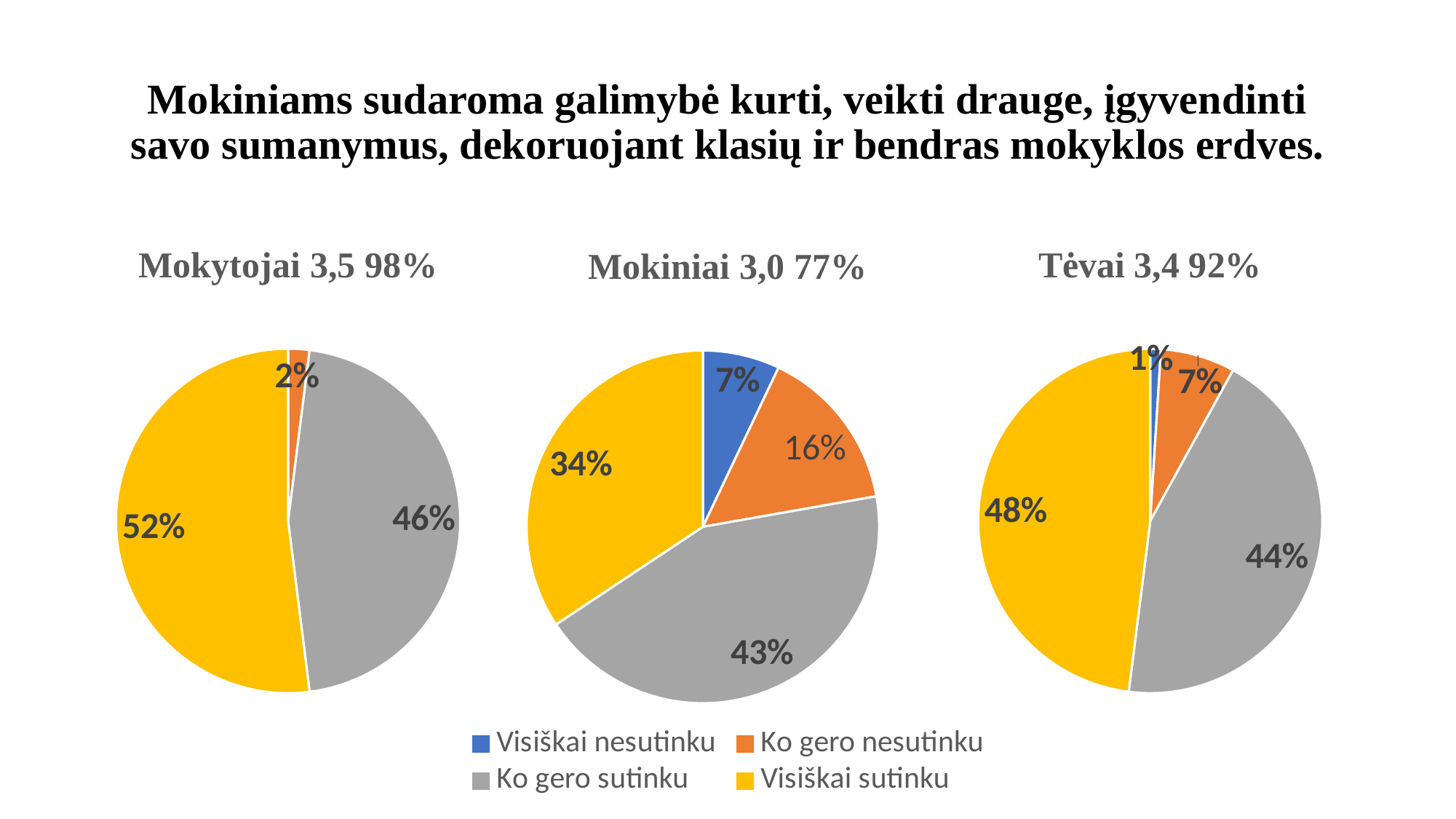
In the 'Mokytojai 3,5 98%' pie chart, what share is 'Visiškai sutinku'? 52% In the 'Tėvai 3,4 92%' pie chart, what share is 'Ko gero sutinku'? 44% Which colour represents 'Visiškai sutinku' in the legend? Yellow In the 'Tėvai 3,4 92%' pie chart, which category has the smallest slice? Visiškai nesutinku In the 'Tėvai 3,4 92%' pie chart, which is larger: 'Visiškai sutinku' or 'Ko gero sutinku'? Visiškai sutinku In the 'Mokiniai 3,0 77%' pie chart, which category has the largest slice? Ko gero sutinku In the 'Mokiniai 3,0 77%' pie chart, what is the difference between the 'Ko gero sutinku' and 'Visiškai sutinku' shares? 9% How many categories does the legend list? 4 In the 'Mokytojai 3,5 98%' pie chart, what share is 'Ko gero nesutinku'? 2% In the 'Mokiniai 3,0 77%' pie chart, what is the combined share of 'Visiškai nesutinku' and 'Ko gero nesutinku'? 23% What type of charts are shown on the slide? Pie charts